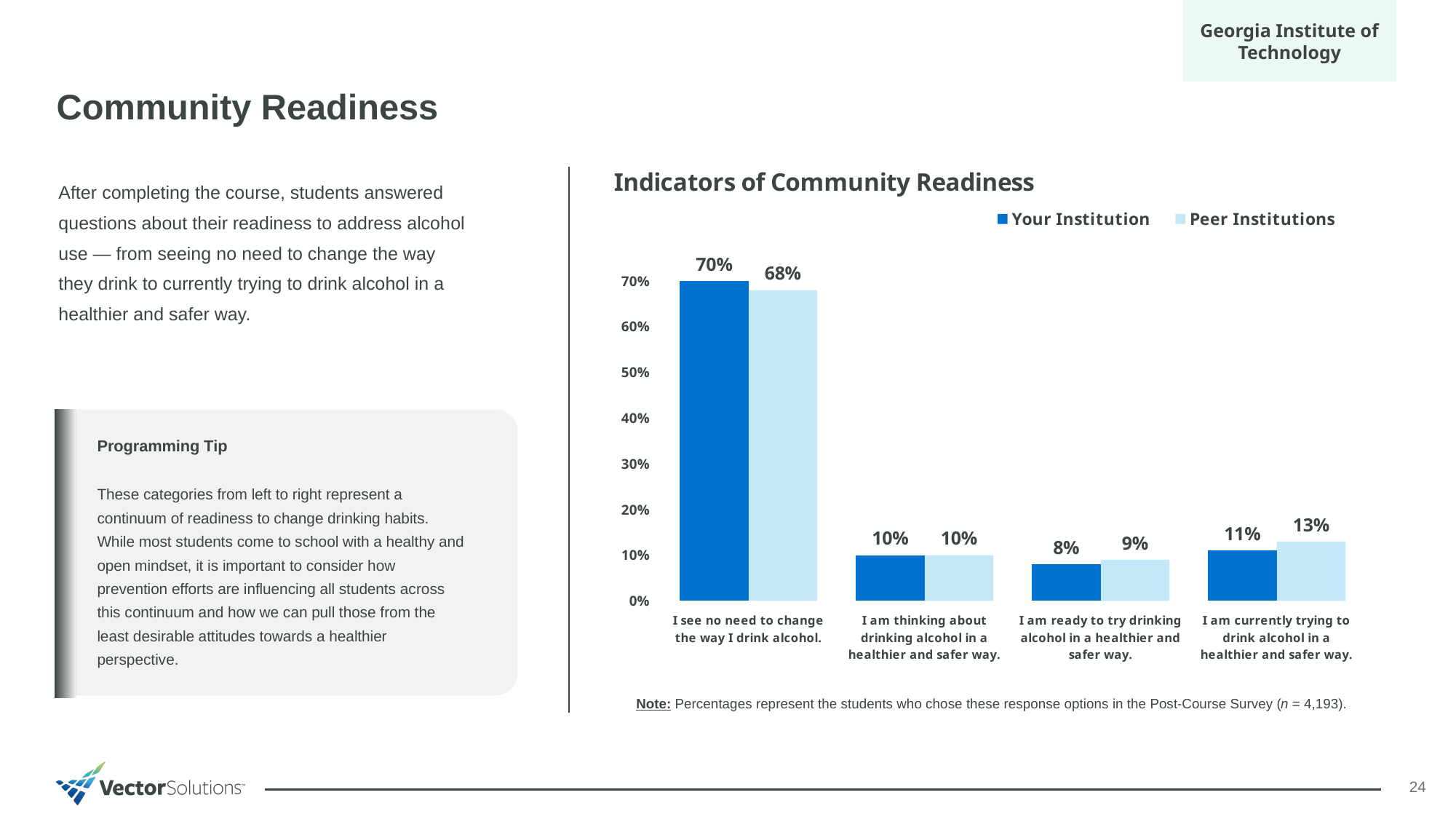
Is the Peer Institutions value for "I see no need to change the way I drink alcohol." greater or less than 60%? greater What is the Your Institution value for "I am ready to try drinking alcohol in a healthier and safer way."? 8% What is the difference between the Your Institution and Peer Institutions values for "I see no need to change the way I drink alcohol."? 2% Which category has the lowest Peer Institutions value? I am ready to try drinking alcohol in a healthier and safer way. What is the title of the chart? Indicators of Community Readiness How many categories are shown on the x axis? 4 What kind of chart is shown? Bar chart What is the Your Institution value for "I see no need to change the way I drink alcohol."? 70% What is the Peer Institutions value for "I am currently trying to drink alcohol in a healthier and safer way."? 13% Which category has the highest Your Institution value? I see no need to change the way I drink alcohol. For "I am currently trying to drink alcohol in a healthier and safer way.", which is larger: Your Institution or Peer Institutions? Peer Institutions How many series does the legend list? 2